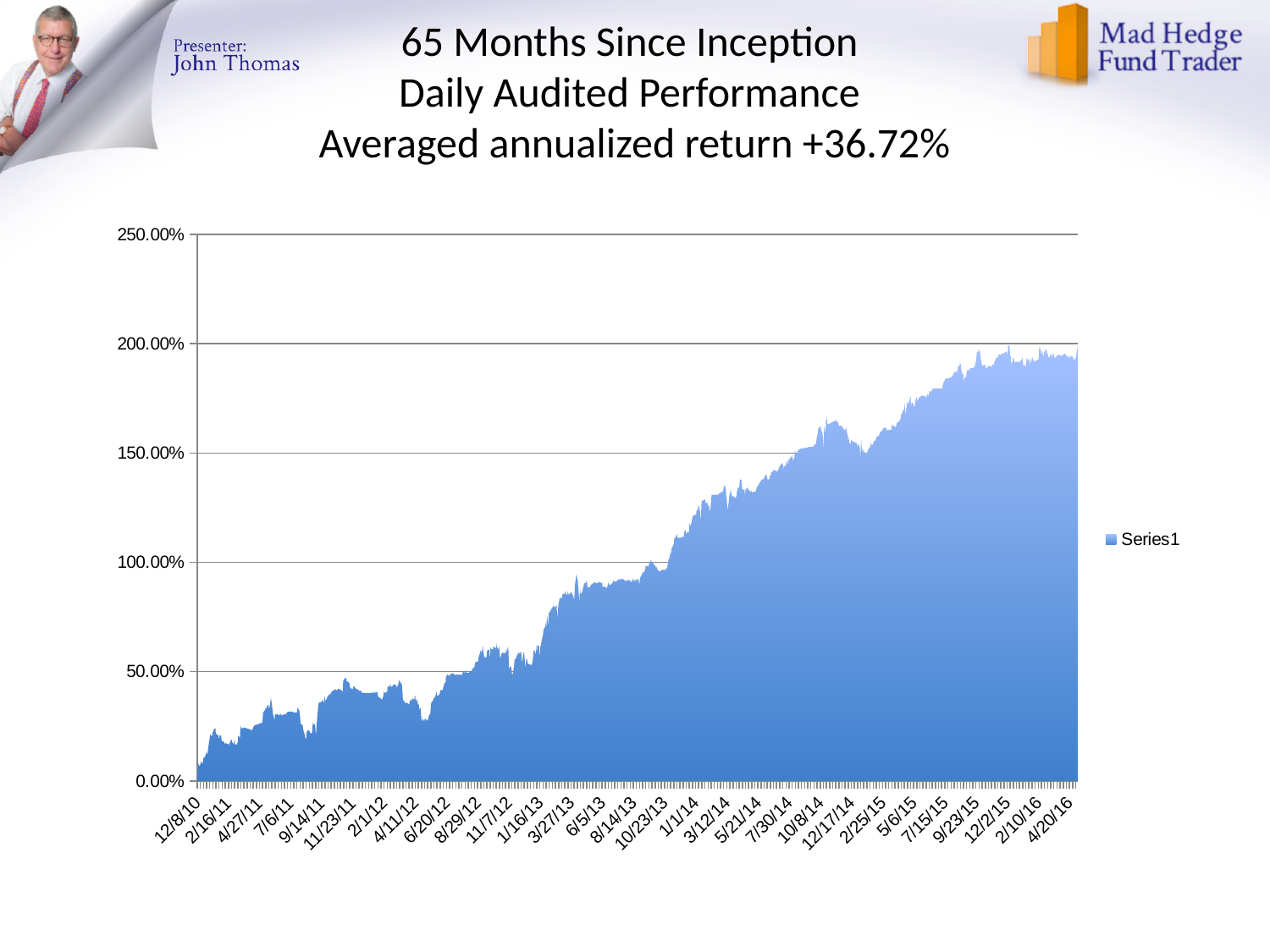
Is the value at 12/8/10 greater or less than 50.00%? less Is the value at 3/27/13 greater or less than 50.00%? greater What is the name of the series shown in the legend? Series1 What averaged annualized return is stated in the chart title? +36.72% Is the value at 1/1/14 greater or less than 100.00%? greater Do the values generally rise or fall from 12/8/10 to 4/20/16? rise How many series does the legend list? 1 What kind of chart is shown on the slide? area chart